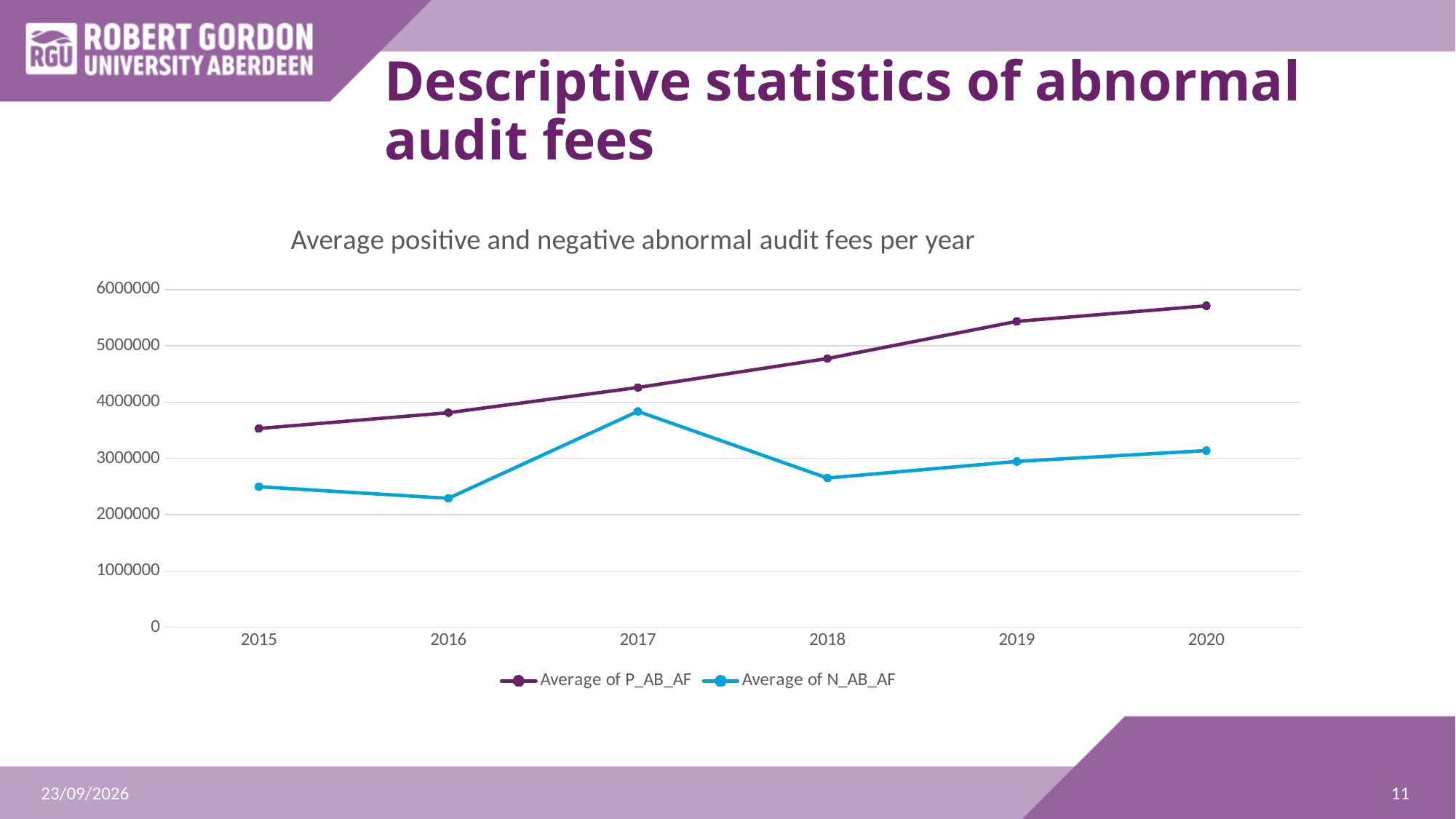
In which year is the Average of P_AB_AF lowest? 2015 Is the value for Average of P_AB_AF in 2020 greater or less than 5000000? greater In 2018, which series has the larger value, Average of P_AB_AF or Average of N_AB_AF? Average of P_AB_AF Is the value for Average of N_AB_AF in 2016 greater or less than 3000000? less How many years are plotted along the x axis? 6 In which year is the Average of N_AB_AF highest? 2017 In which year is the Average of N_AB_AF lowest? 2016 What is the title of the chart? Average positive and negative abnormal audit fees per year How many series does the legend list? 2 Does the Average of P_AB_AF series rise or fall from 2015 to 2020? rise What kind of chart is shown on the slide? line chart In which year is the Average of P_AB_AF highest? 2020